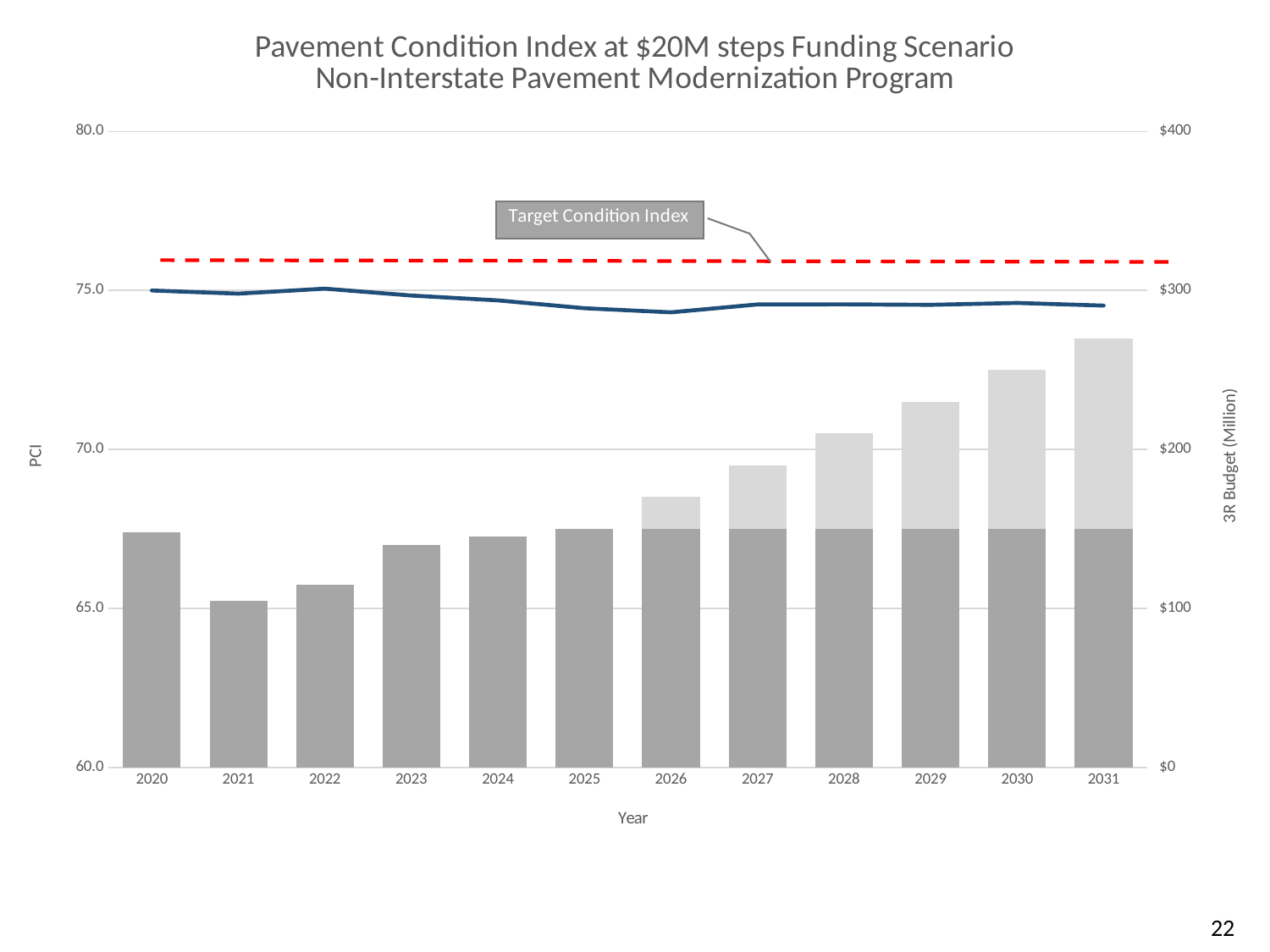
What kind of chart is shown on the slide? A combination of a bar chart and a line chart Which year has the tallest total bar? 2031 What does the callout label attached to the dashed red line say? Target Condition Index Is the dashed red Target Condition Index line above or below 75.0 on the PCI axis? above How many years are shown along the x axis? 12 Is the bar for 2021 greater or less than $150 on the right-hand axis? less Is the PCI line value for 2026 greater or less than 75.0? less Do the total bars rise or fall from 2025 to 2031? rise What is the label of the right-hand vertical axis? 3R Budget (Million) Is the total bar for 2030 taller or shorter than the bar for 2023? taller Which year has the shortest bar? 2021